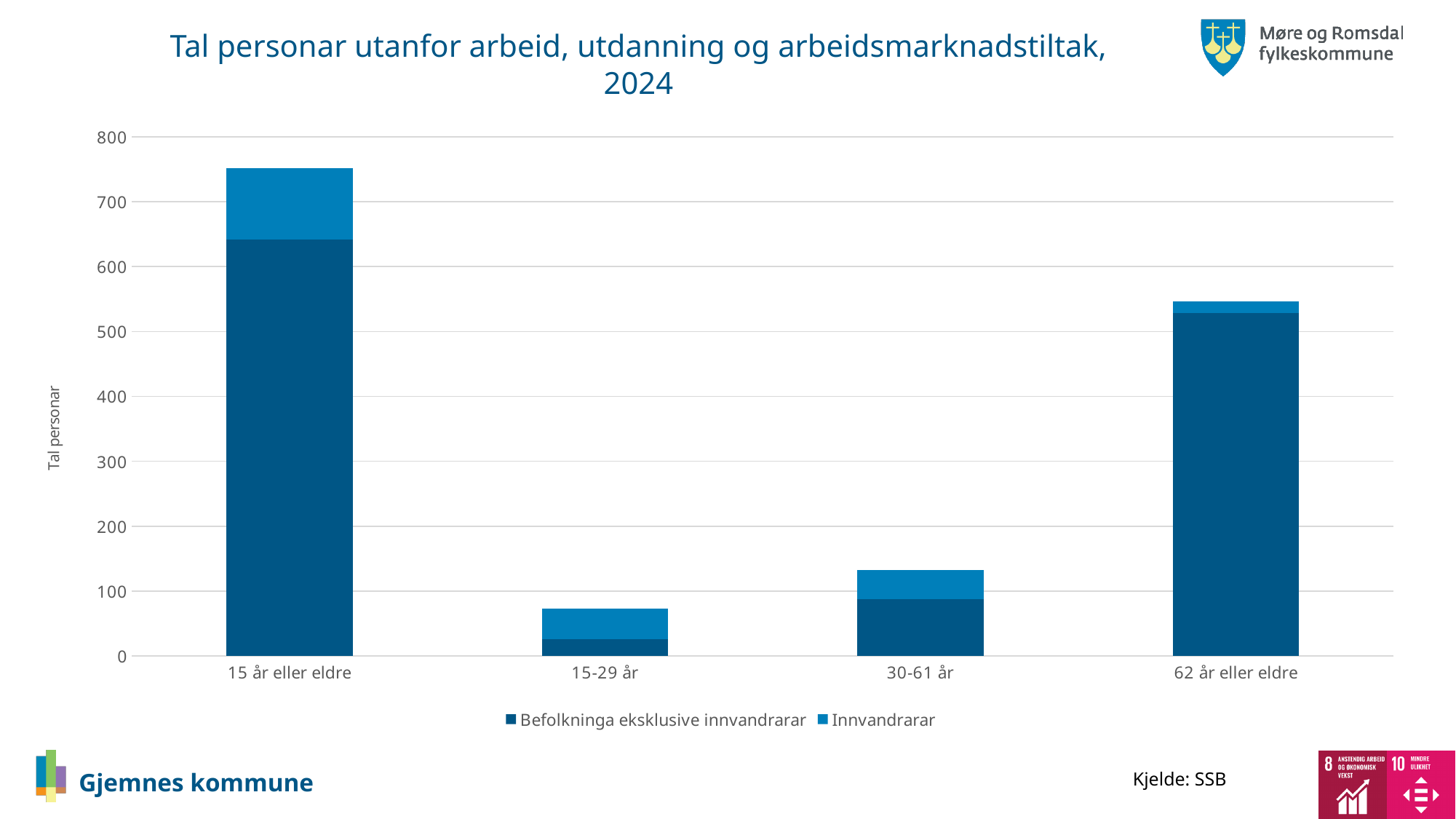
Is the Befolkninga eksklusive innvandrarar value for 15 år eller eldre greater or less than 600? greater Which category has the highest total bar? 15 år eller eldre Is the total value for 15 år eller eldre greater or less than 700? greater What kind of chart is shown on the slide? bar chart How many series does the legend list? 2 How many age categories are shown on the x axis? 4 Which category has the lowest total bar? 15-29 år What is the label on the y axis? Tal personar Is the total value for 62 år eller eldre greater or less than 500? greater Which has the larger total bar, 30-61 år or 15-29 år? 30-61 år